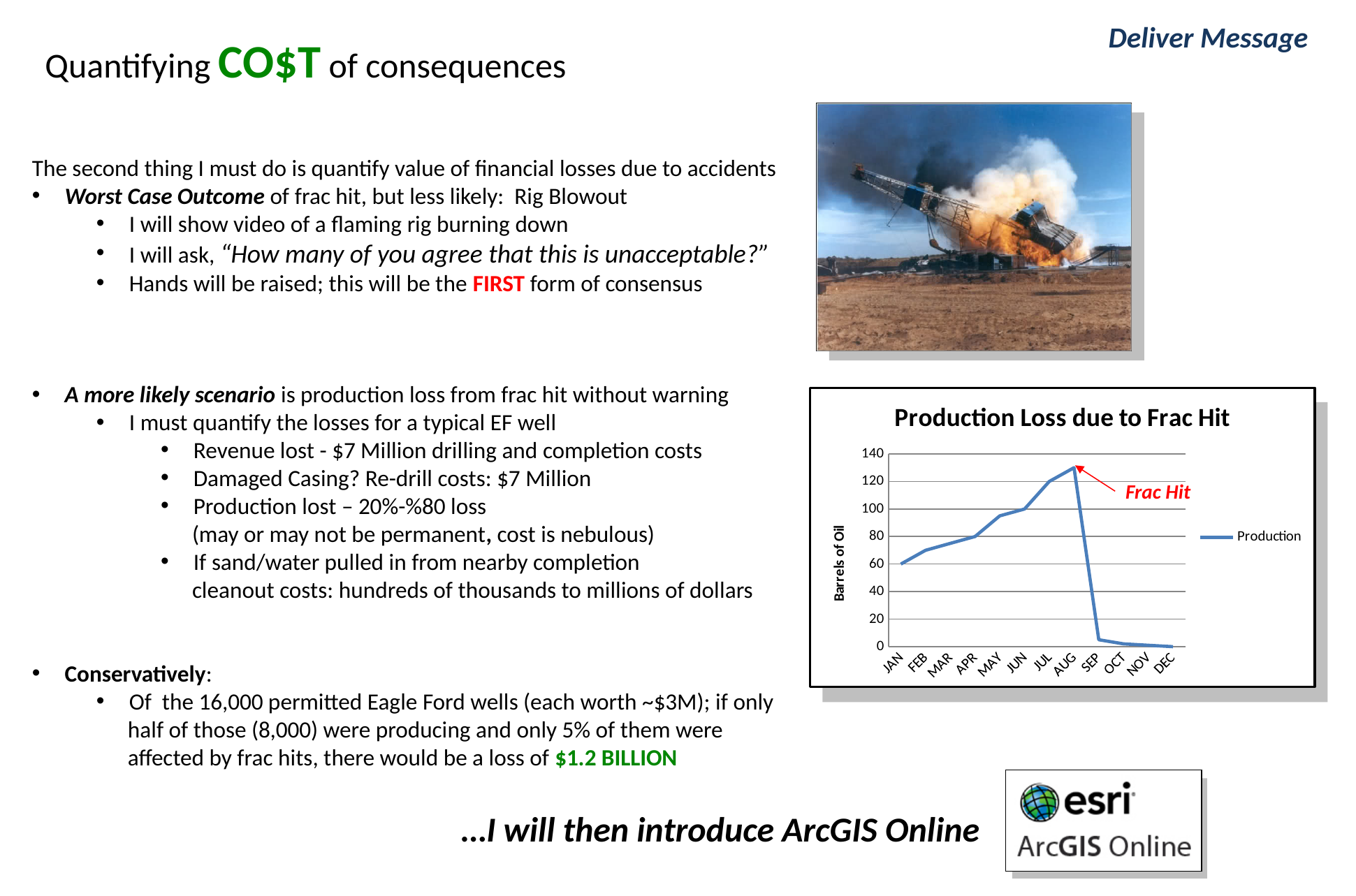
Which month has the highest production value in the chart? AUG What label is on the y axis of the chart? Barrels of Oil Is the production value for MAY greater or less than 80? greater Do the production values rise or fall from JAN to AUG? rise Is the production value for SEP greater or less than 20? less Is the production value for FEB greater or less than 80? less Which month has the larger production value, JUL or SEP? JUL What is the title of the chart on the slide? Production Loss due to Frac Hit How many months are plotted along the x axis of the chart? 12 What kind of chart is shown on the slide? line chart How many series does the chart legend list? 1